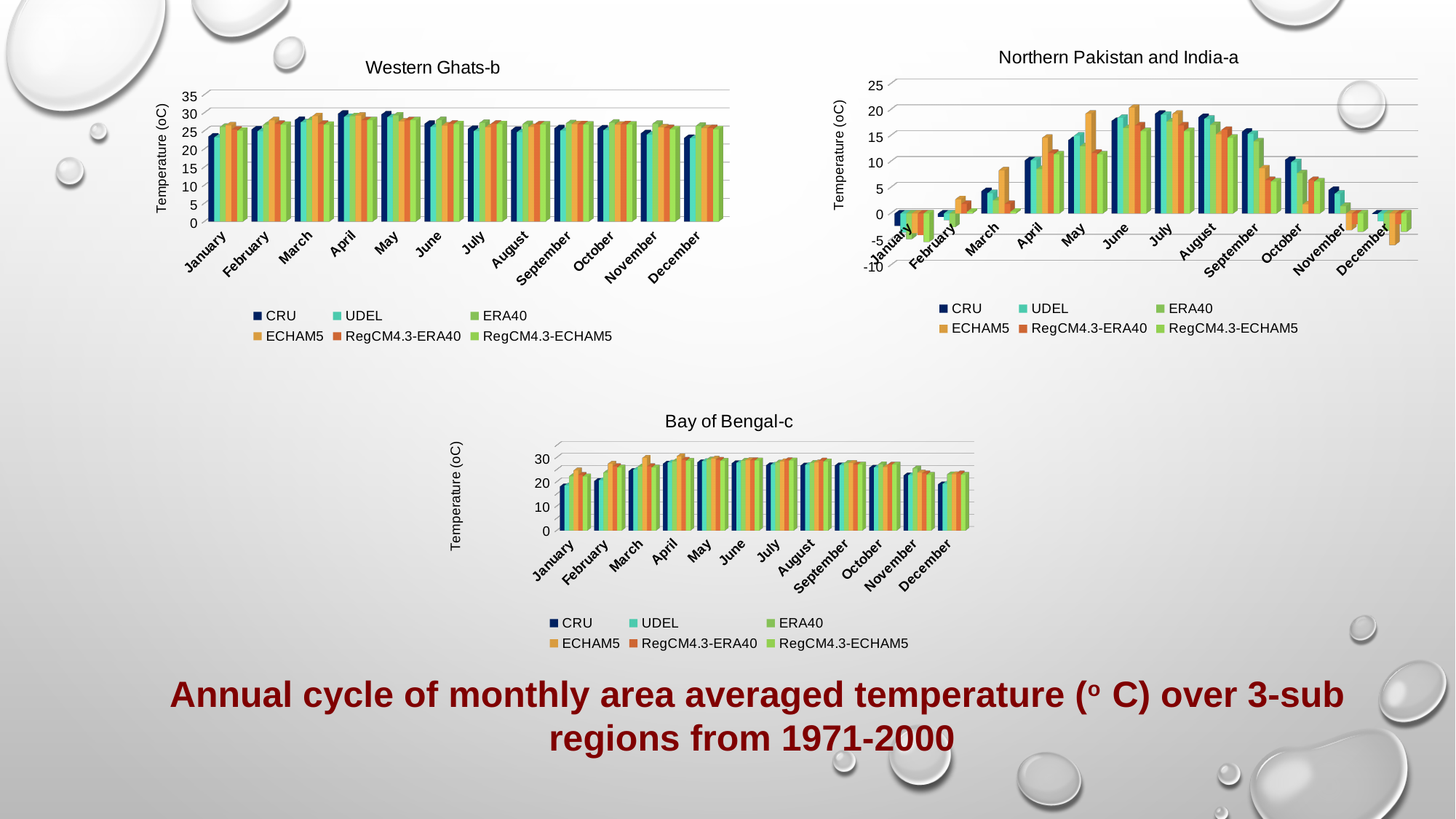
In the Western Ghats-b chart, is the CRU value for December greater or less than 25? less In the Northern Pakistan and India-a chart, which is larger, the CRU value for July or the CRU value for March? July How many series does the legend of the Northern Pakistan and India-a chart list? 6 What kind of chart is the Western Ghats-b chart? bar chart In the Western Ghats-b chart, is the CRU value for January greater or less than 20? greater In the Bay of Bengal-c chart, is the CRU value for January greater or less than 20? less What is the y-axis label on the Bay of Bengal-c chart? Temperature (oC) How many months are shown on the x axis of the Bay of Bengal-c chart? 12 In the Northern Pakistan and India-a chart, do the CRU values rise or fall from January to July? rise